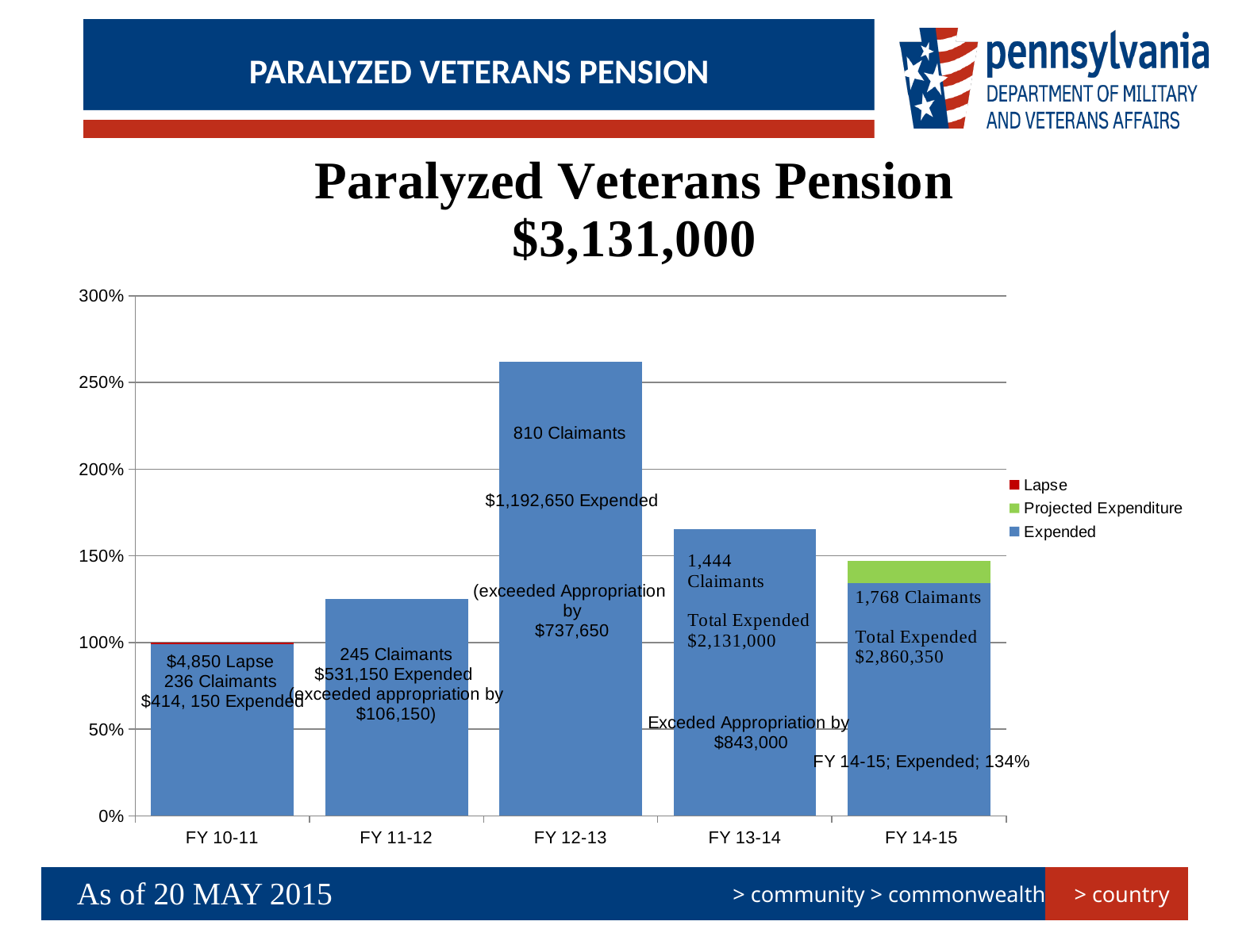
What is the Expended percentage labelled for FY 14-15? 134% Which fiscal year has the tallest bar in the chart? FY 12-13 Which bar is taller, FY 13-14 or FY 14-15? FY 13-14 What kind of chart is shown on the slide? bar chart Is the bar for FY 12-13 greater or less than 250%? greater Is the bar for FY 11-12 greater or less than 150%? less Which fiscal year has the shortest bar in the chart? FY 10-11 How many fiscal years are shown along the x axis of the chart? 5 Is the bar for FY 13-14 greater or less than 150%? greater What are the three series named in the chart legend? Lapse, Projected Expenditure, Expended How many series does the chart legend list? 3 How many claimants are labelled on the FY 12-13 bar? 810 Claimants